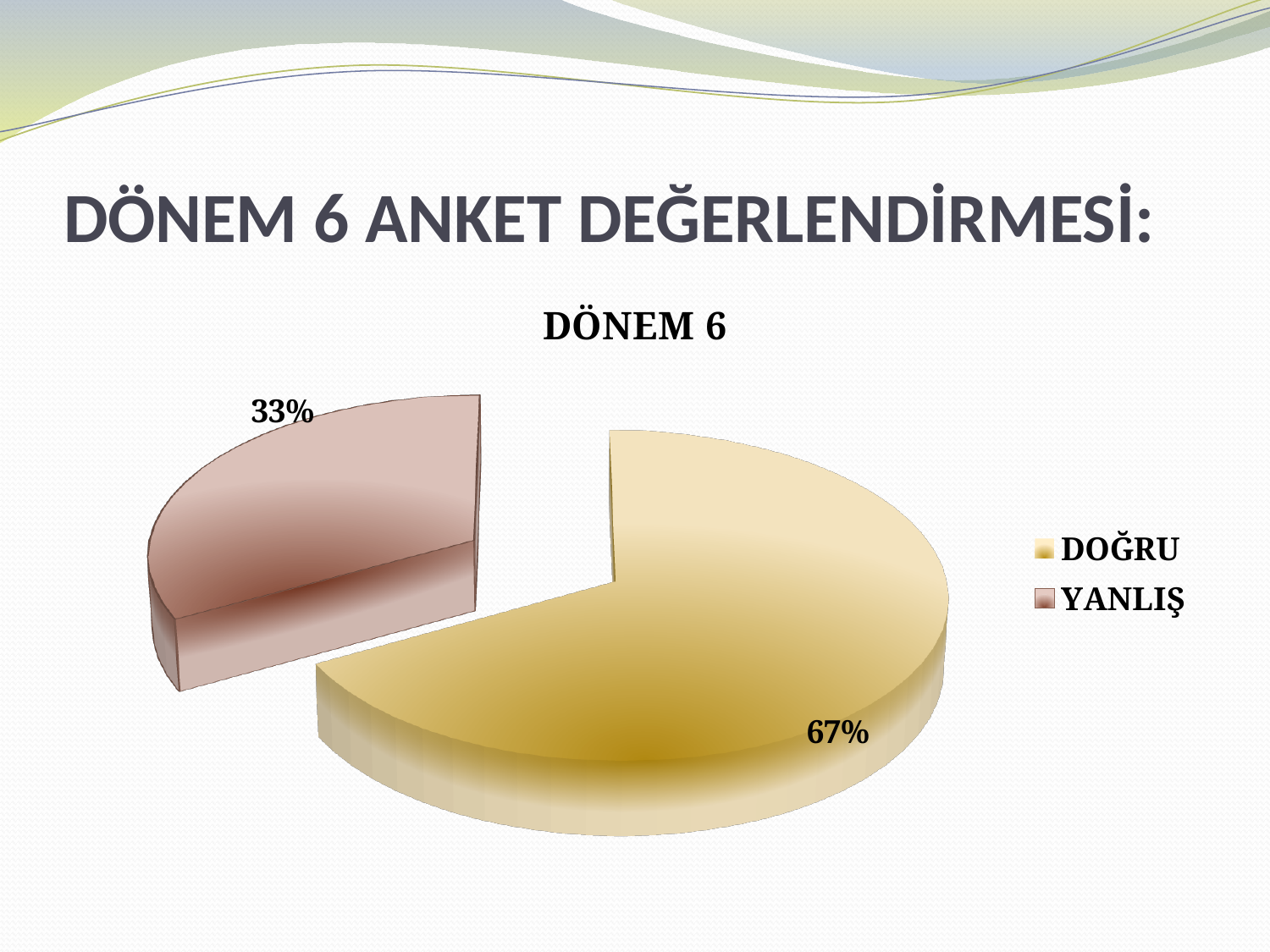
What is the difference in percentage points between DOĞRU and YANLIŞ? 34 Which is larger, the DOĞRU slice or the YANLIŞ slice? DOĞRU What percentage of the pie is DOĞRU? 67% What is the share of the pie taken by the DOĞRU slice? 67% How many slices does the pie chart have? 2 What percentage of the pie is YANLIŞ? 33% Which category has the largest share of the pie? DOĞRU Which category has the smallest share of the pie? YANLIŞ What is the title of the chart? DÖNEM 6 How many entries does the legend list? 2 What type of chart is shown on the slide? Pie chart What colour is the YANLIŞ slice? Pink